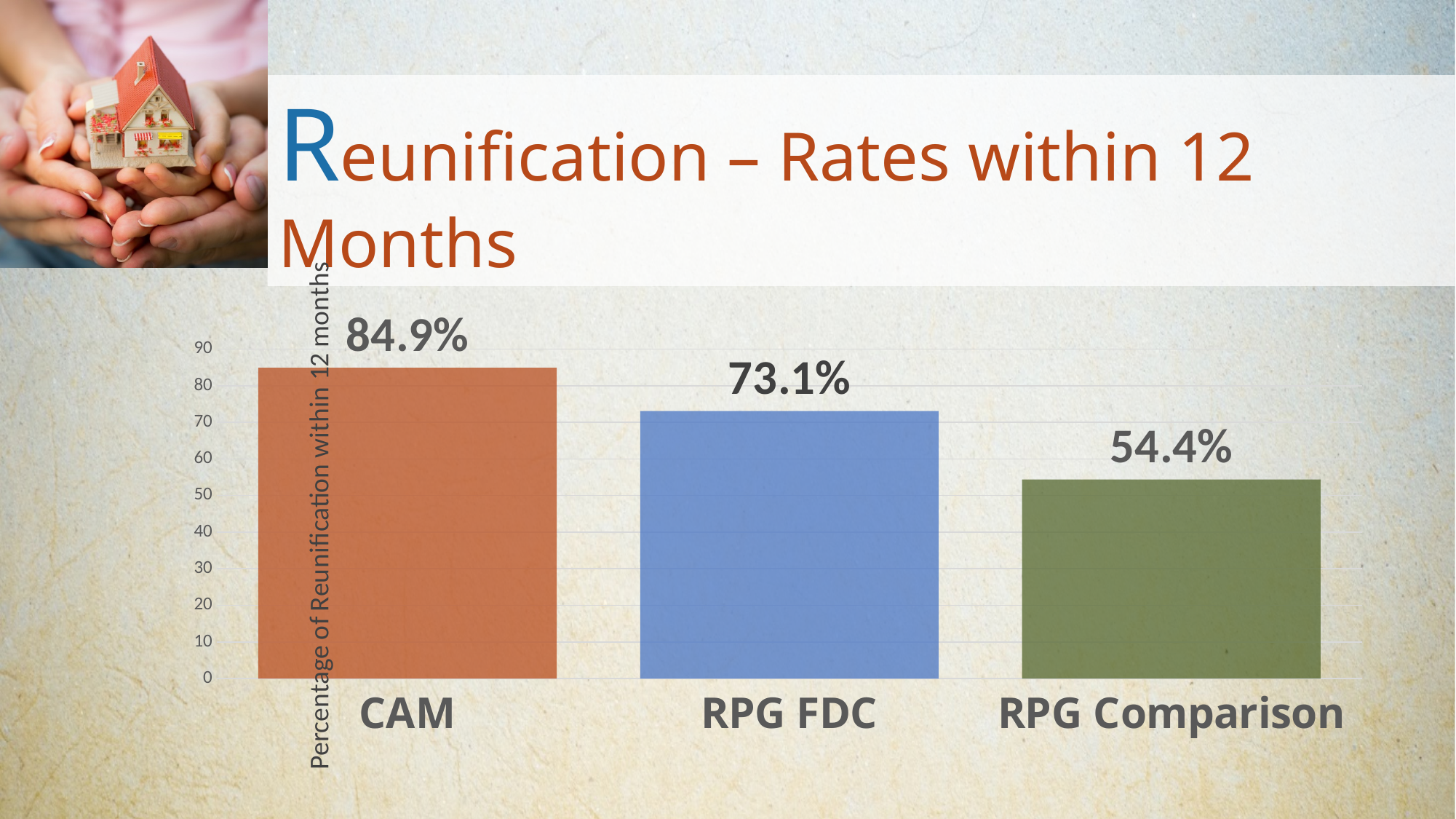
What is the reunification rate within 12 months for RPG FDC? 73.1% Is the value for RPG FDC greater or less than 70? greater What is the difference in reunification rate between CAM and RPG Comparison? 30.5% What is the reunification rate within 12 months for RPG Comparison? 54.4% What is the label on the vertical axis of the chart? Percentage of Reunification within 12 months How many categories are shown in the chart? 3 Which category has the highest reunification rate? CAM Which has a higher reunification rate, RPG FDC or RPG Comparison? RPG FDC What is the difference in reunification rate between CAM and RPG FDC? 11.8% Which category has the lowest reunification rate? RPG Comparison What kind of chart is shown on the slide? Bar chart What is the reunification rate within 12 months for CAM? 84.9%